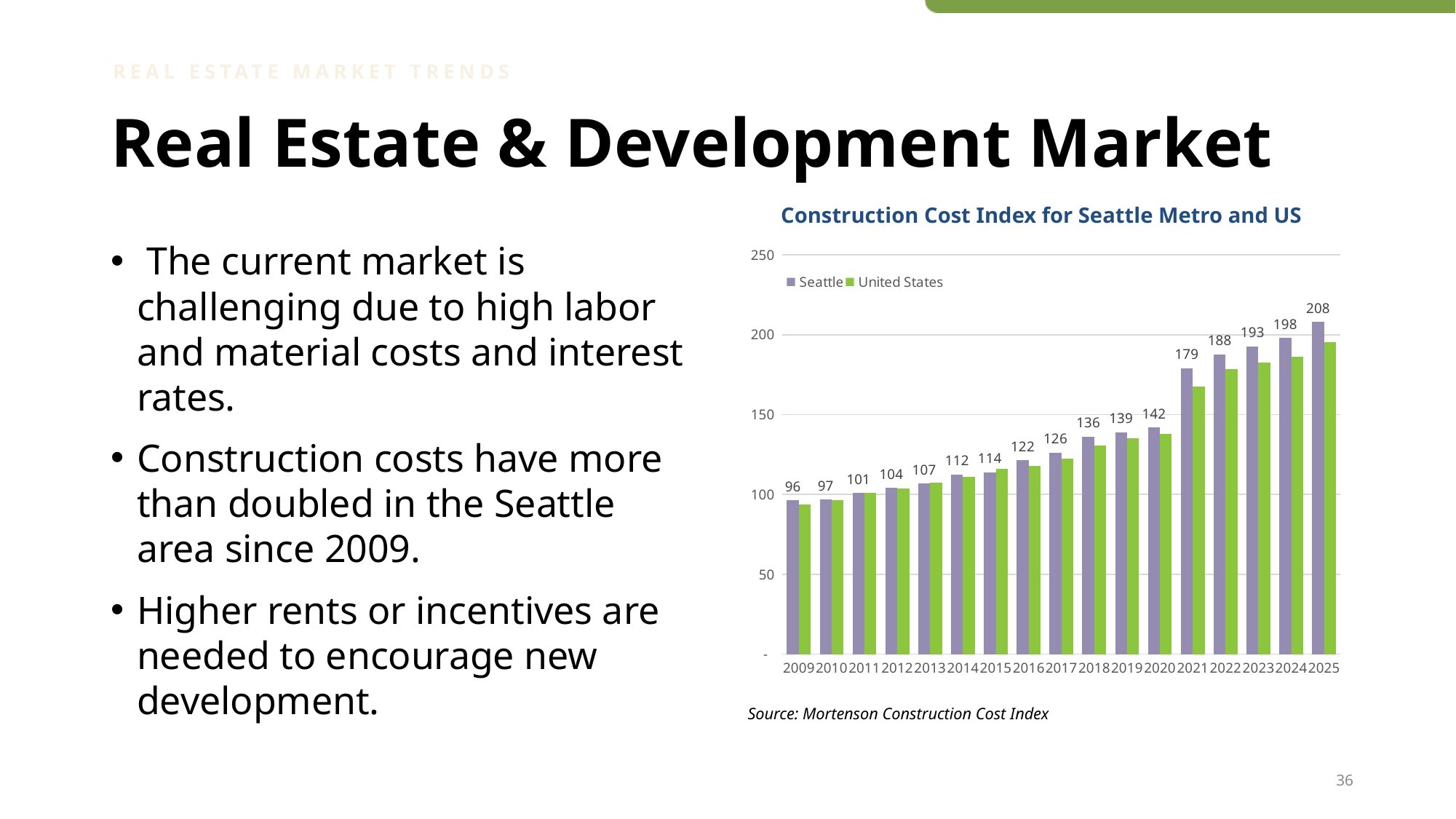
Is the United States value for 2025 in the Construction Cost Index chart greater or less than 150? greater Which year has the highest Seattle value in the Construction Cost Index chart? 2025 What is the Seattle value for 2009 in the Construction Cost Index chart? 96 What kind of chart is the Construction Cost Index for Seattle Metro and US? Bar chart What is the Seattle value for 2021 in the Construction Cost Index chart? 179 How many years are shown on the x axis of the Construction Cost Index chart? 17 In 2021, which series has the larger value in the Construction Cost Index chart, Seattle or United States? Seattle What is the difference between the Seattle values for 2025 and 2009 in the Construction Cost Index chart? 112 How many series does the legend of the Construction Cost Index chart list? 2 Which year has the lowest Seattle value in the Construction Cost Index chart? 2009 Do the Seattle values in the Construction Cost Index chart rise or fall from 2009 to 2025? Rise What is the Seattle value for 2018 in the Construction Cost Index chart? 136